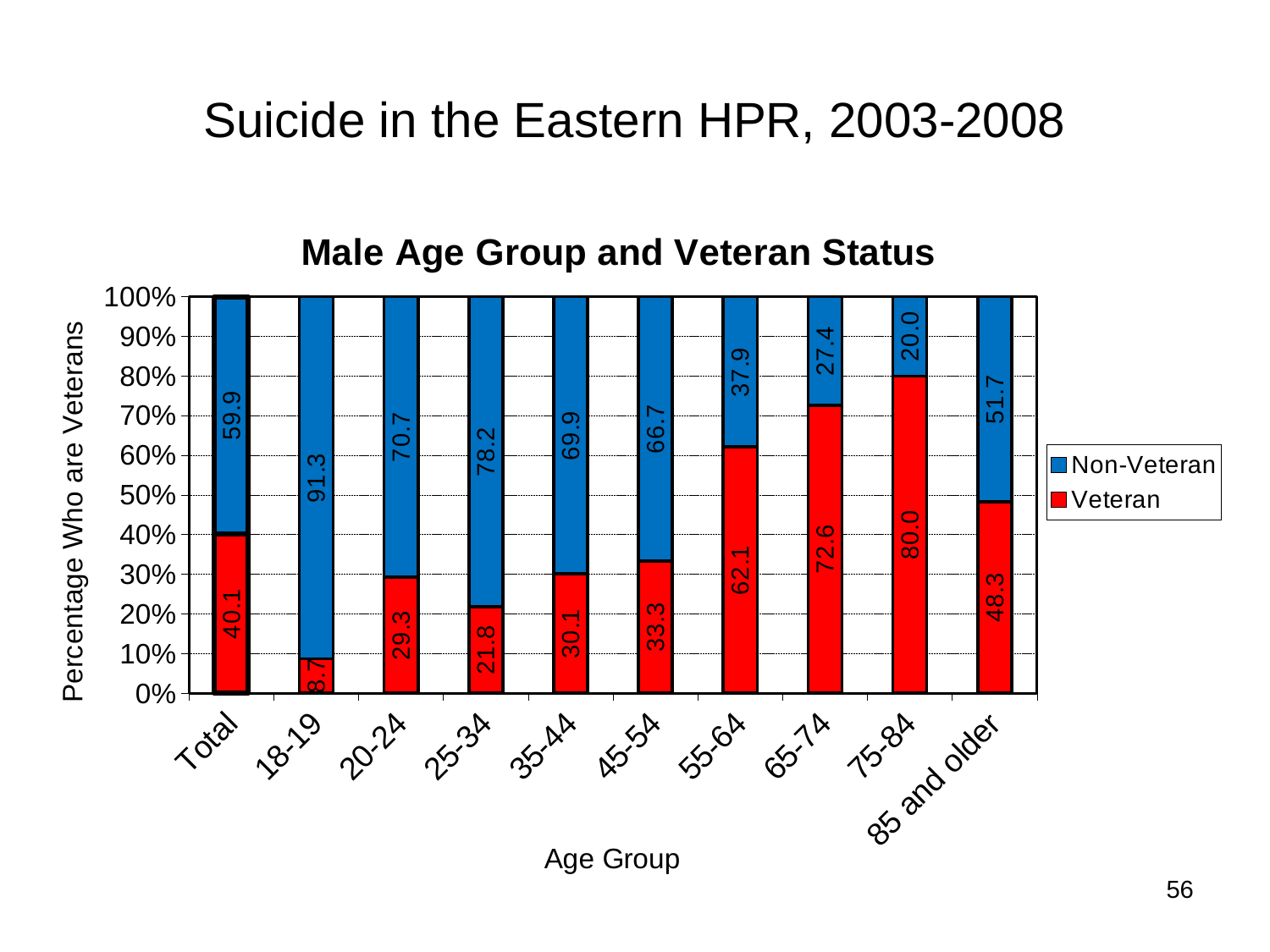
What is the total of the stacked bar for the 25-34 age group? 100.0 What is the Veteran value for the Total category? 40.1 What is the title of the chart? Male Age Group and Veteran Status Which is larger, the Veteran value for 85 and older or for 45-54? 85 and older Which age group has the lowest Veteran value? 18-19 How many series does the legend list? 2 What is the Non-Veteran value for the 18-19 age group? 91.3 What is the difference between the Veteran values for 65-74 and 55-64? 10.5 What kind of chart is this? Stacked bar chart How many categories are shown on the x axis? 10 Which age group has the highest Veteran value? 75-84 What is the Veteran value for the 75-84 age group? 80.0